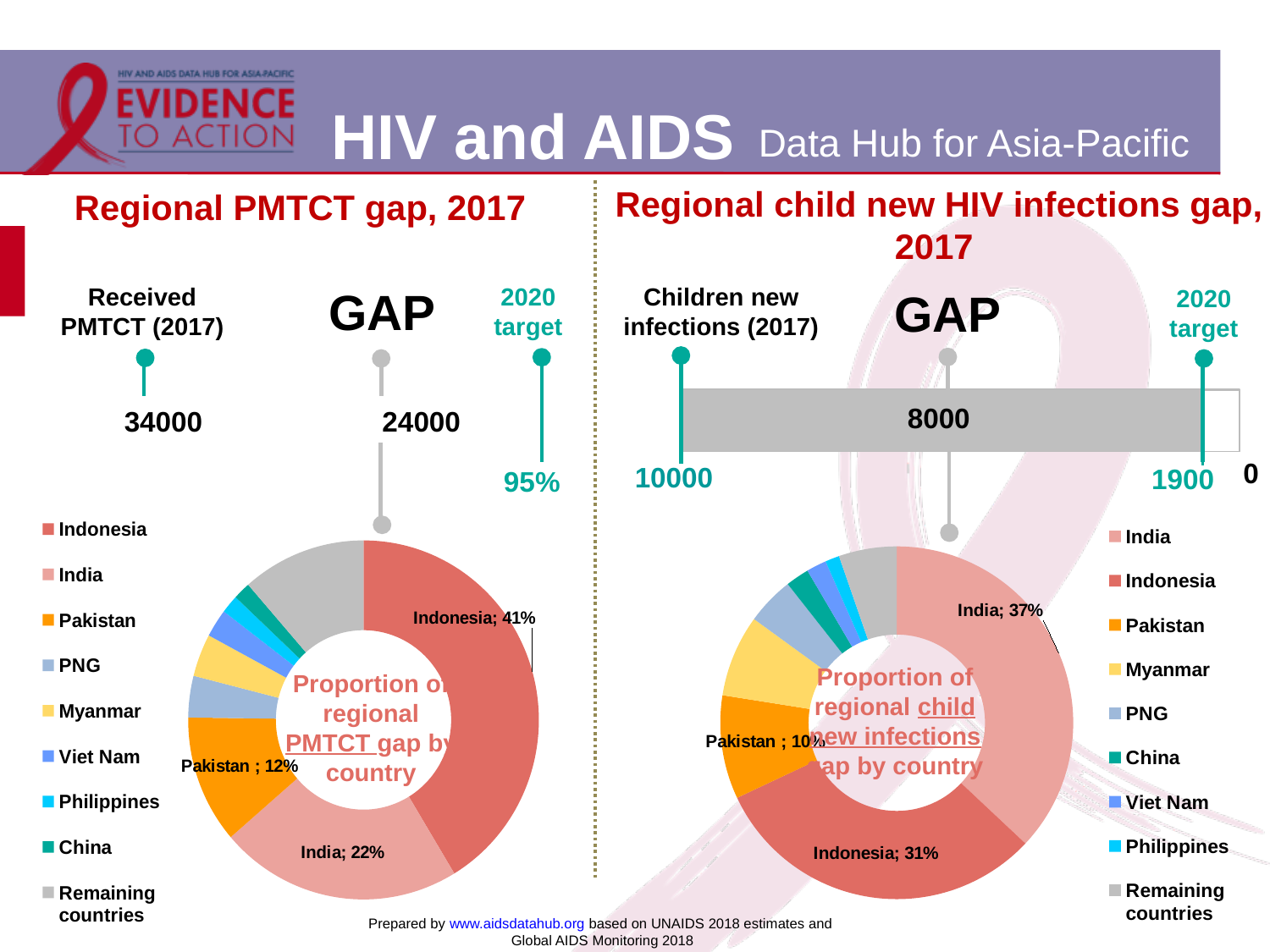
In the left donut chart (Proportion of regional PMTCT gap by country), what share is labelled for Pakistan? 12% In the left donut chart (Proportion of regional PMTCT gap by country), how many percentage points larger is Indonesia's share than India's? 19 In the right donut chart (Proportion of regional child new infections gap by country), what share is labelled for Pakistan? 10% In the right donut chart (Proportion of regional child new infections gap by country), what share is labelled for India? 37% What kind of chart is used to show the proportion of the regional child new infections gap by country on the right of the slide? Pie (donut) chart In the left donut chart (Proportion of regional PMTCT gap by country), which country has the largest share? Indonesia In the left donut chart (Proportion of regional PMTCT gap by country), what share is labelled for India? 22% How many entries does the legend of the left donut chart (Proportion of regional PMTCT gap by country) list? 9 In the right donut chart (Proportion of regional child new infections gap by country), which is larger, the share for India or the share for Indonesia? India In the left donut chart (Proportion of regional PMTCT gap by country), what share is labelled for Indonesia? 41% In the right donut chart (Proportion of regional child new infections gap by country), what share is labelled for Indonesia? 31% In the right donut chart (Proportion of regional child new infections gap by country), which country has the largest share? India